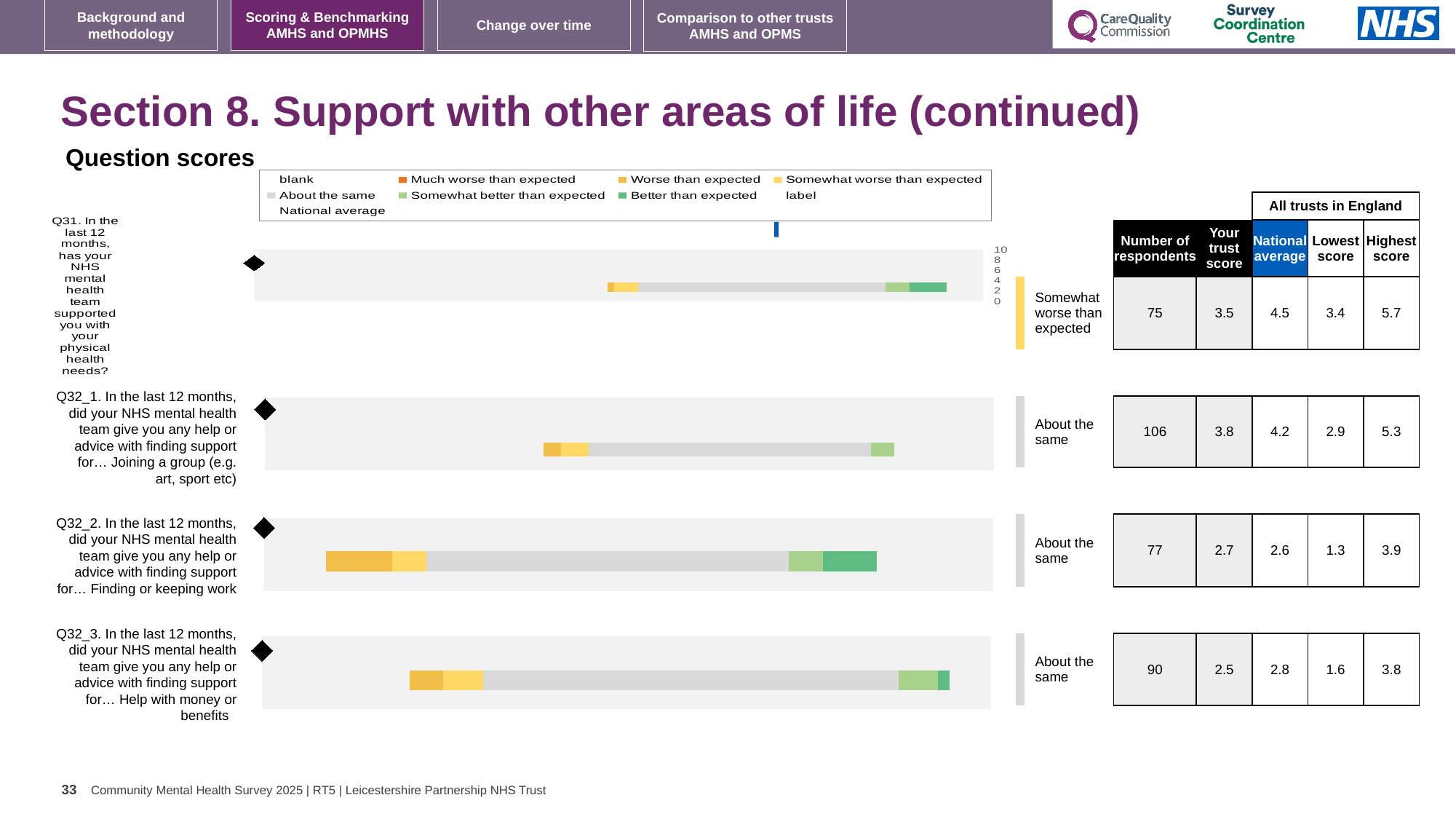
For Q32_2 (finding or keeping work), which is larger: the trust score or the national average? the trust score What is the number of respondents for Q31 (support with physical health needs)? 75 What is the highest score among all trusts in England for Q32_3 (help with money or benefits)? 3.8 Which question has the lowest trust score? Q32_3 (help with money or benefits) What kind of chart is used to show the question scores on this slide? bar chart What is the national average for Q32_2 (help with finding or keeping work)? 2.6 What is the trust score for Q32_1 (help with joining a group)? 3.8 How many questions (bars) are plotted on the slide? 4 What is the difference between the national average and the trust score for Q31? 1.0 Which question has the highest number of respondents? Q32_1 (joining a group) What benchmark category is shown for Q31 (support with physical health needs)? Somewhat worse than expected What is the lowest score among all trusts in England for Q32_1 (joining a group)? 2.9